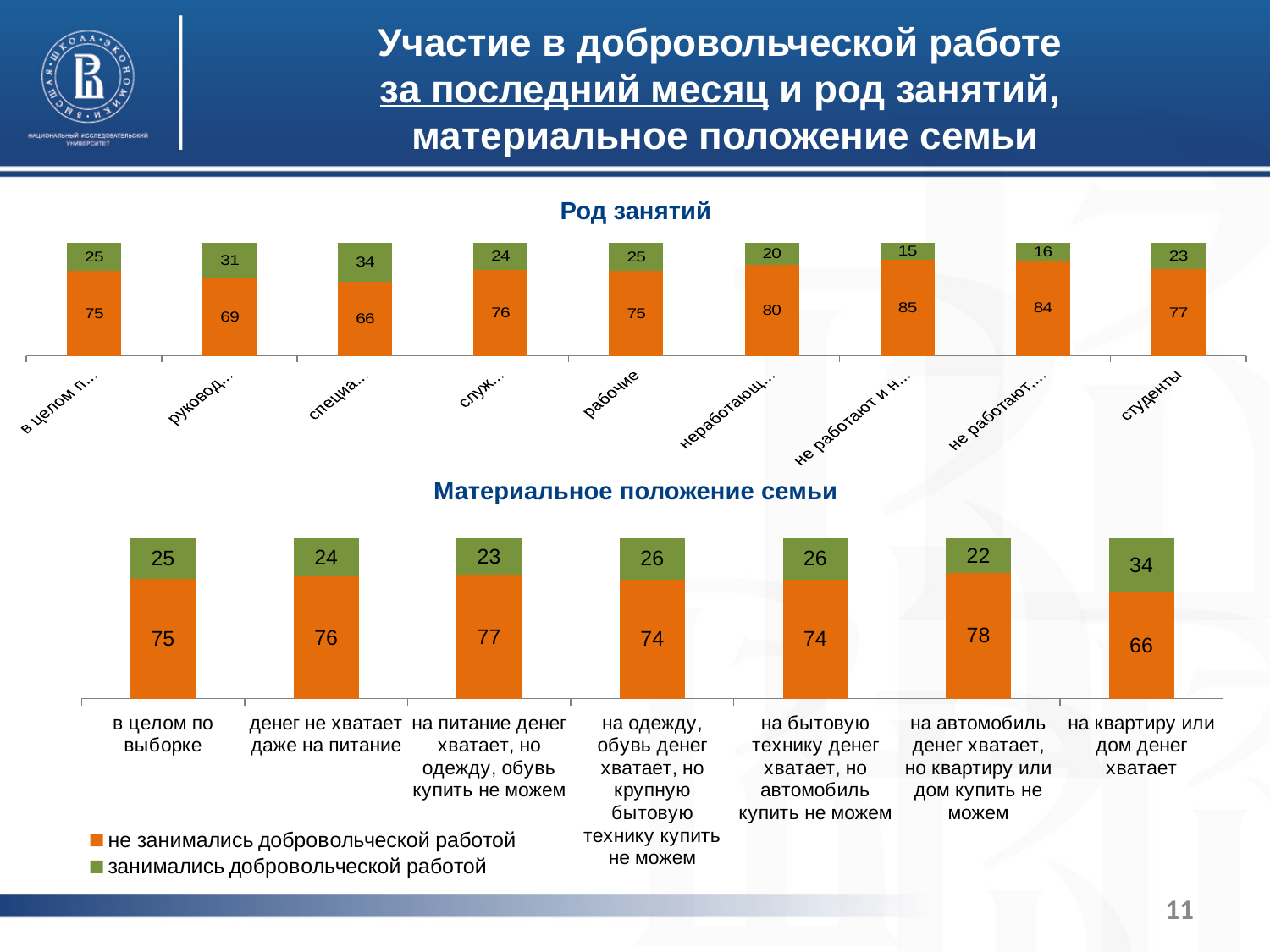
On the 'Материальное положение семьи' chart, what is the value for 'не занимались добровольческой работой' for 'на автомобиль денег хватает, но квартиру или дом купить не можем'? 78 On the 'Материальное положение семьи' chart, what is the value for 'занимались добровольческой работой' for 'на квартиру или дом денег хватает'? 34 On the 'Материальное положение семьи' chart, how many categories are shown? 7 On the 'Материальное положение семьи' chart, what is the difference between the 'занимались добровольческой работой' values for 'на квартиру или дом денег хватает' and 'в целом по выборке'? 9 On the 'Материальное положение семьи' chart, which category has the lowest value for 'не занимались добровольческой работой'? на квартиру или дом денег хватает On the 'Материальное положение семьи' chart, which category has the highest value for 'занимались добровольческой работой'? на квартиру или дом денег хватает On the 'Род занятий' chart, how many categories are shown on the x axis? 9 How many series does the legend list? 2 What type of chart is the 'Материальное положение семьи' chart? stacked bar chart On the 'Род занятий' chart, what is the total of the stacked bar for студенты? 100 On the 'Род занятий' chart, what is the value for 'занимались добровольческой работой' for студенты? 23 On the 'Род занятий' chart, what is the value for 'не занимались добровольческой работой' for рабочие? 75